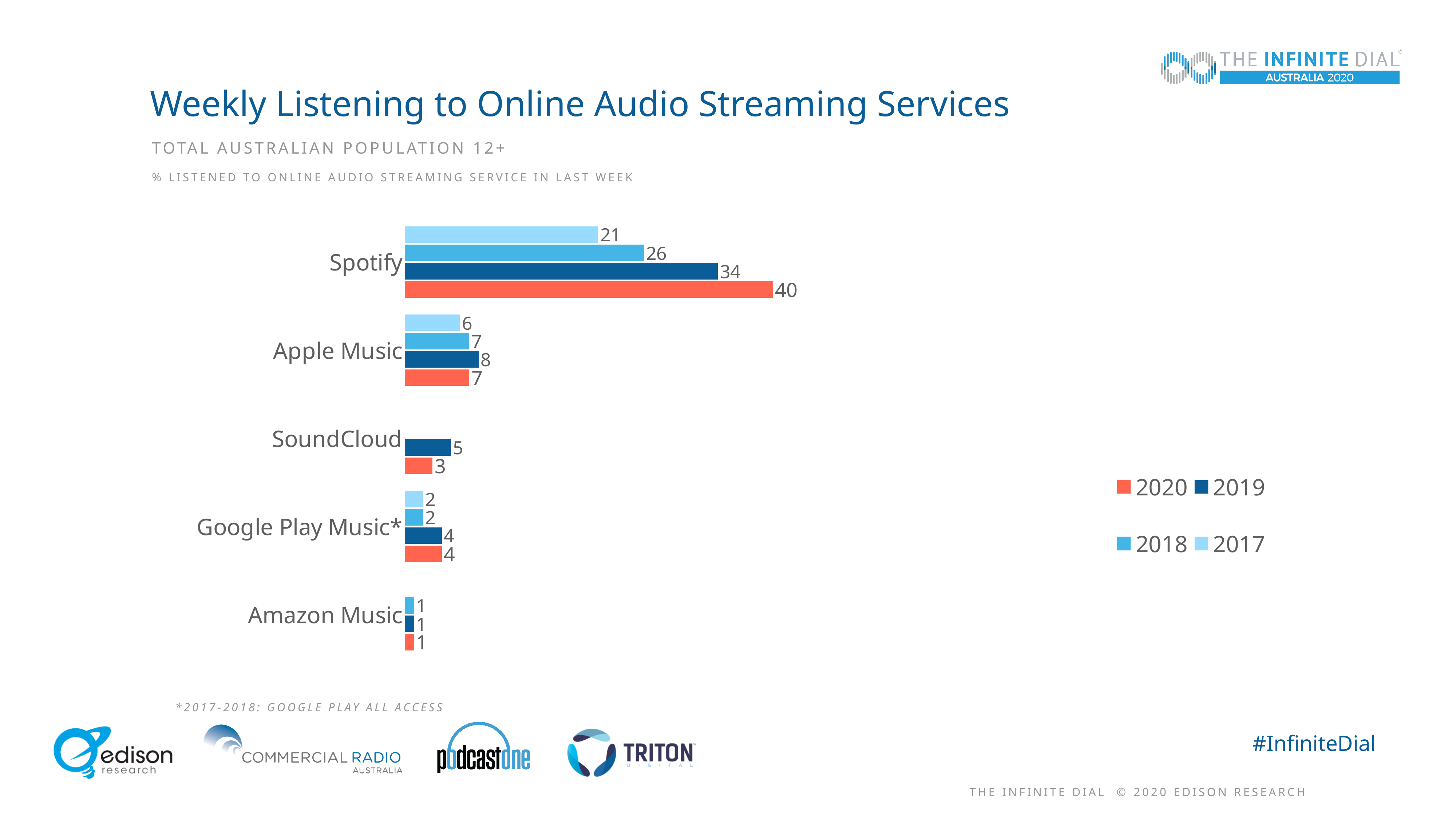
What is the 2020 value for Spotify? 40 What is the 2019 value for Apple Music? 8 How many services are shown on the chart? 5 What is the 2020 value for SoundCloud? 3 Do Spotify's values rise or fall from 2017 to 2020? Rise Which service has the lowest 2020 value? Amazon Music Which is larger for Apple Music: the 2019 value or the 2020 value? 2019 What is the 2017 value for Spotify? 21 How many series does the legend list? 4 Which service has the highest 2020 value? Spotify What is the difference between Spotify's 2020 and 2019 values? 6 What kind of chart is shown on the slide? Bar chart